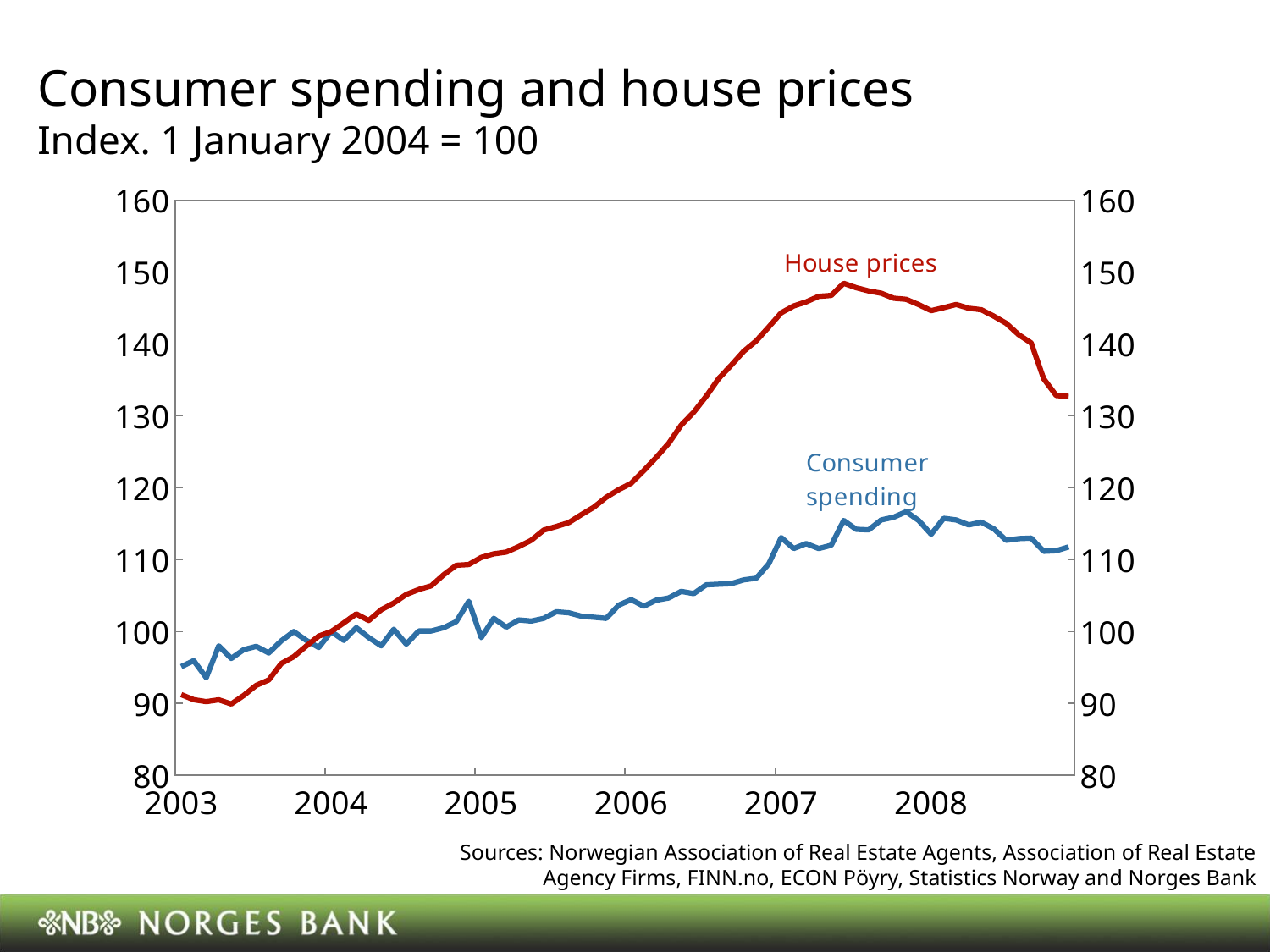
At the start of 2008, which series has the higher value, House prices or Consumer spending? House prices Which series reaches the higher peak value over the period shown? House prices Do House prices rise or fall between the start of 2003 and the start of 2007? rise Is the value for Consumer spending at the start of 2003 greater or less than 100? less Is the value for House prices at the start of 2007 greater or less than 140? greater What kind of chart is shown on the slide? line chart Is the peak value of House prices greater or less than 150? less How many series are plotted on the chart? 2 What is the title of the chart? Consumer spending and house prices Which colour is used for the House prices line? red